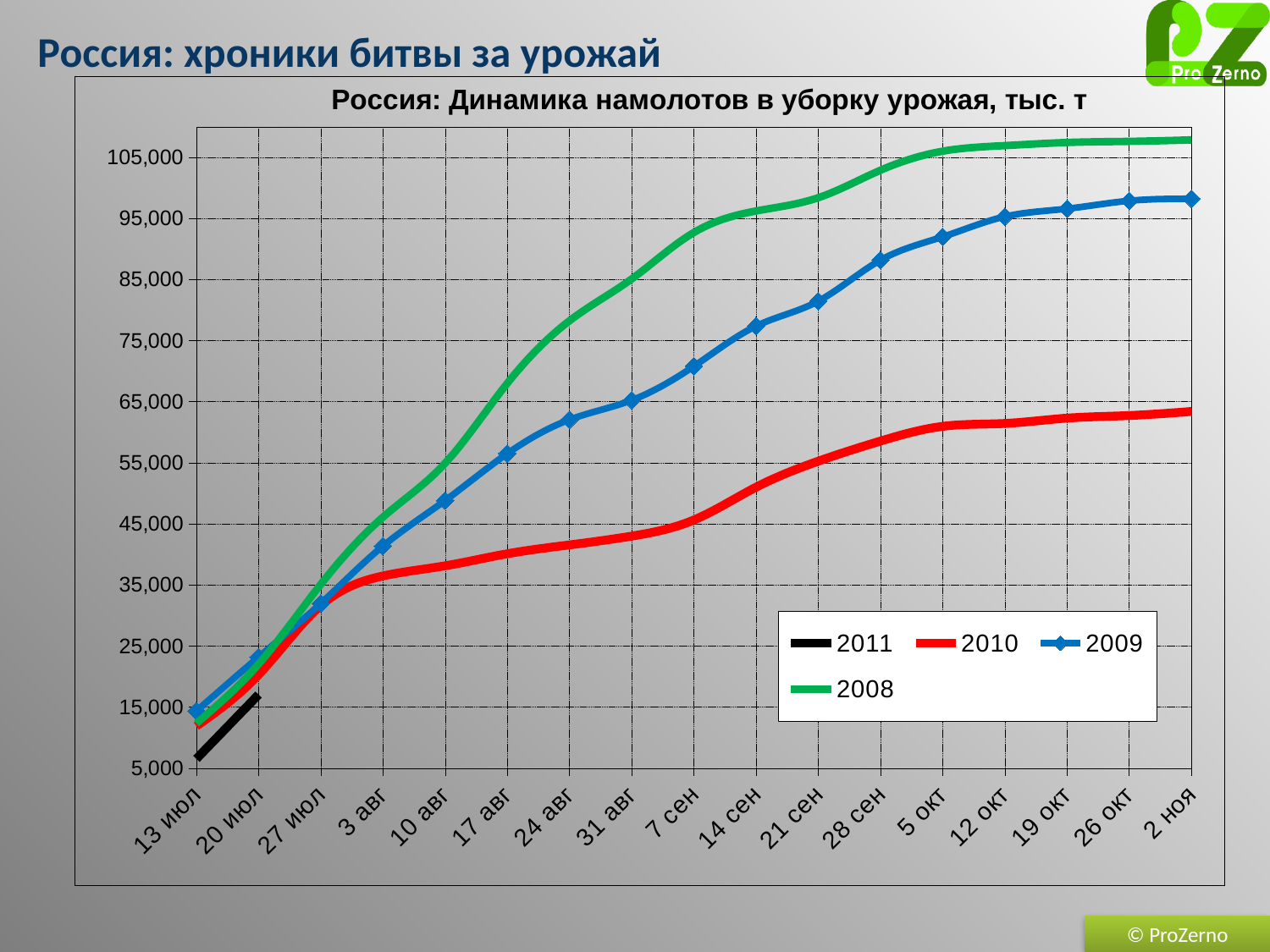
At 2 ноя, which is larger: the value for 2008 or the value for 2009? 2008 Is the value for 2011 at 13 июл greater or less than 15,000? less How many dates are shown along the x axis? 17 Which series is drawn in green? 2008 Is the value for 2010 at 2 ноя greater or less than 55,000? greater Which series has the highest value at 2 ноя? 2008 Is the value for 2009 at 2 ноя greater or less than 95,000? greater What is the title of the chart? Россия: Динамика намолотов в уборку урожая, тыс. т Do the values for the 2009 series rise or fall along the x axis? rise Which series has the lowest value at 2 ноя among the series that reach that date? 2010 What kind of chart is shown on the slide? line chart How many series does the legend list? 4